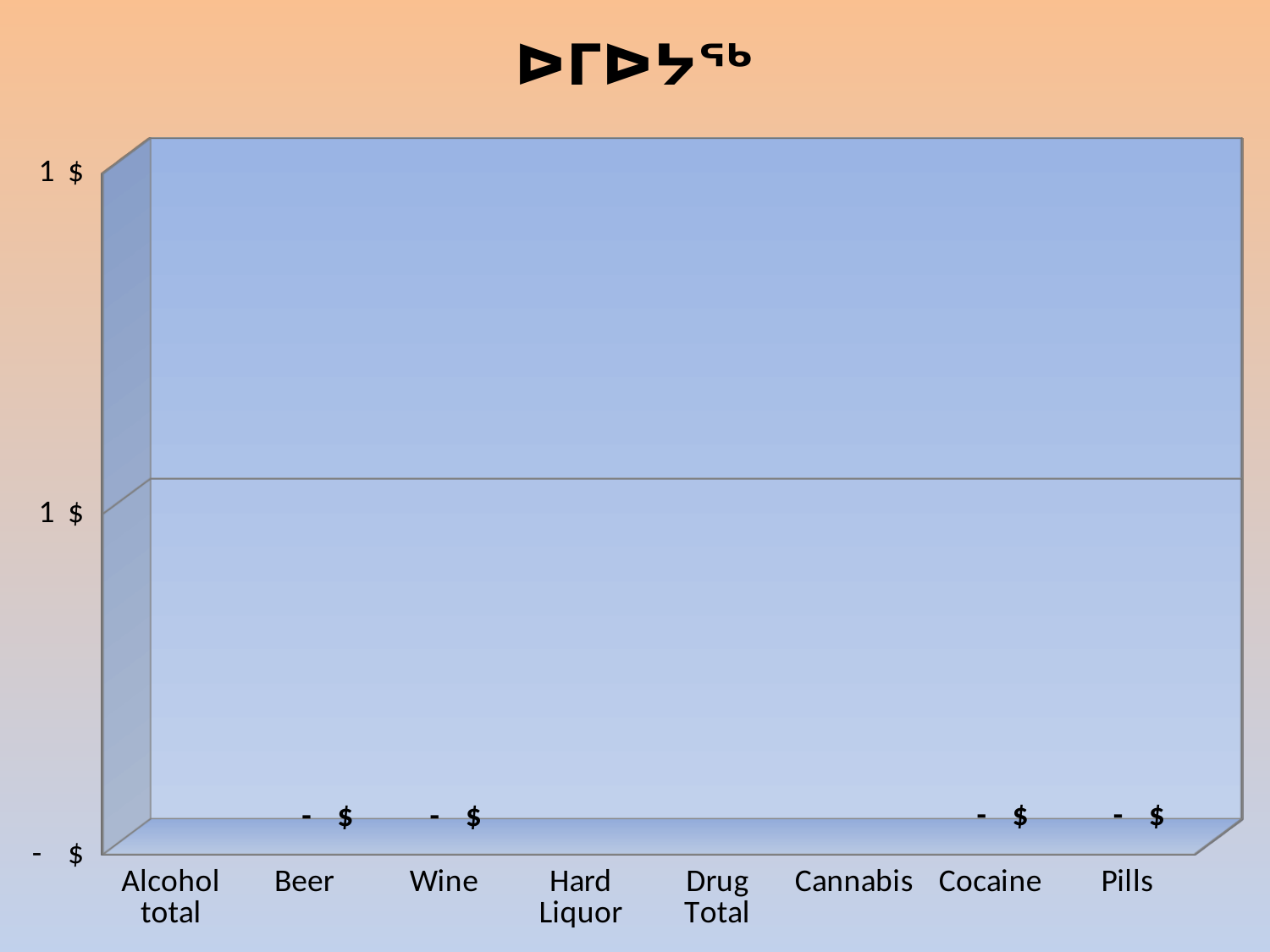
What data label is printed for Beer in the chart? - $ What kind of chart is shown on the slide? bar chart Which category appears between Wine and Drug Total on the x axis of the chart? Hard Liquor What data label is printed for Pills in the chart? - $ Which category appears immediately after Drug Total on the x axis of the chart? Cannabis What data label is printed for Wine in the chart? - $ What is the first category on the x axis of the chart? Alcohol total What data label is printed for Cocaine in the chart? - $ What is the last category on the x axis of the chart? Pills How many categories are listed along the x axis of the chart? 8